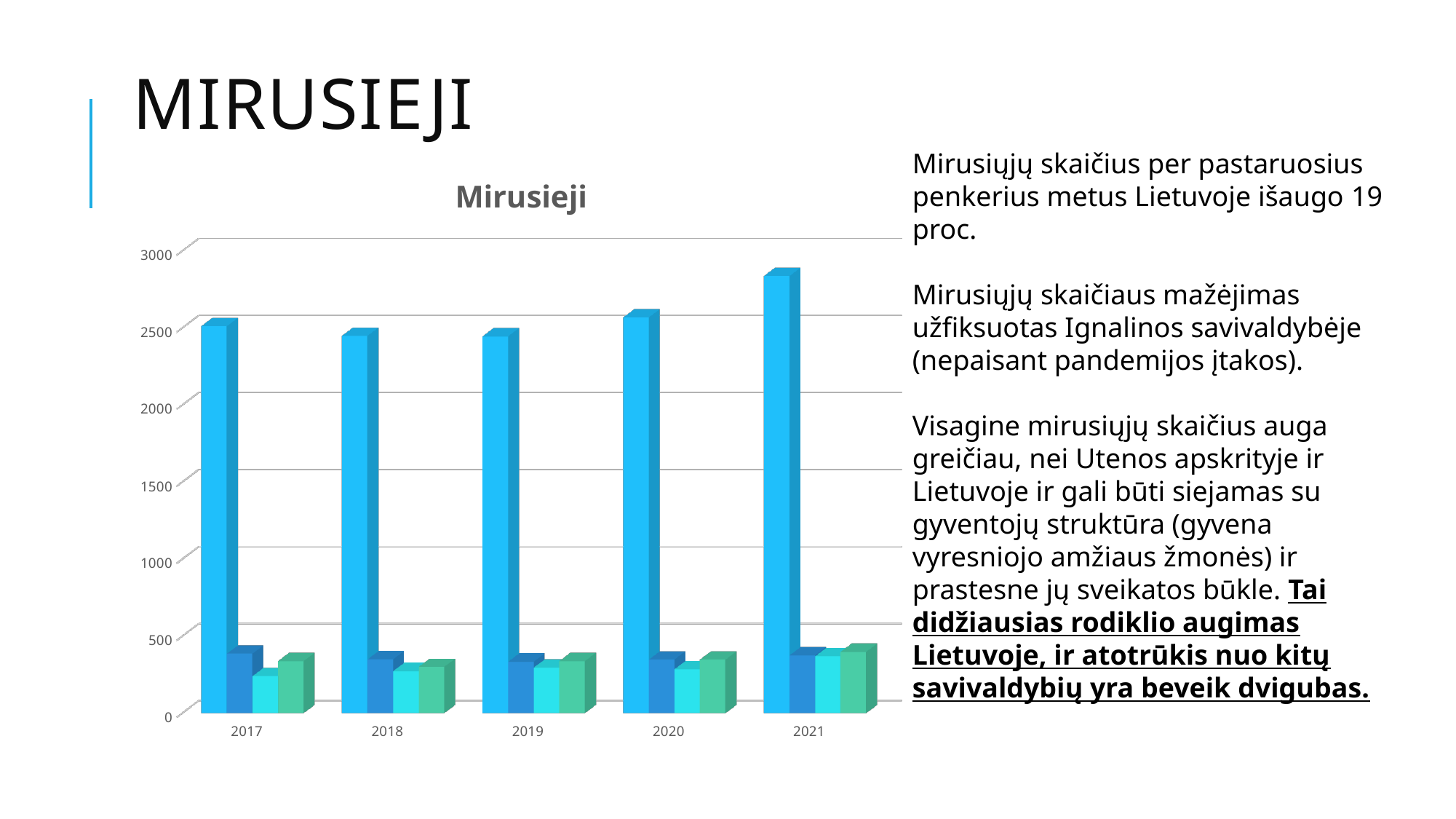
What kind of chart is shown on the slide? bar chart Which year has the larger tallest bar, 2017 or 2021? 2021 In which year is the tallest bar of the chart the highest? 2021 Is the second (dark blue) bar for 2017 greater or less than 500? less Is the tallest bar for 2019 greater or less than 2000? greater Do the tallest bars rise or fall from 2019 to 2021? rise Is the tallest bar for 2021 greater or less than 2500? greater How many bars are plotted for each year in the chart? 4 How many years are shown on the x axis of the chart? 5 What is the highest value shown on the vertical axis of the chart? 3000 What is the title of the chart? Mirusieji